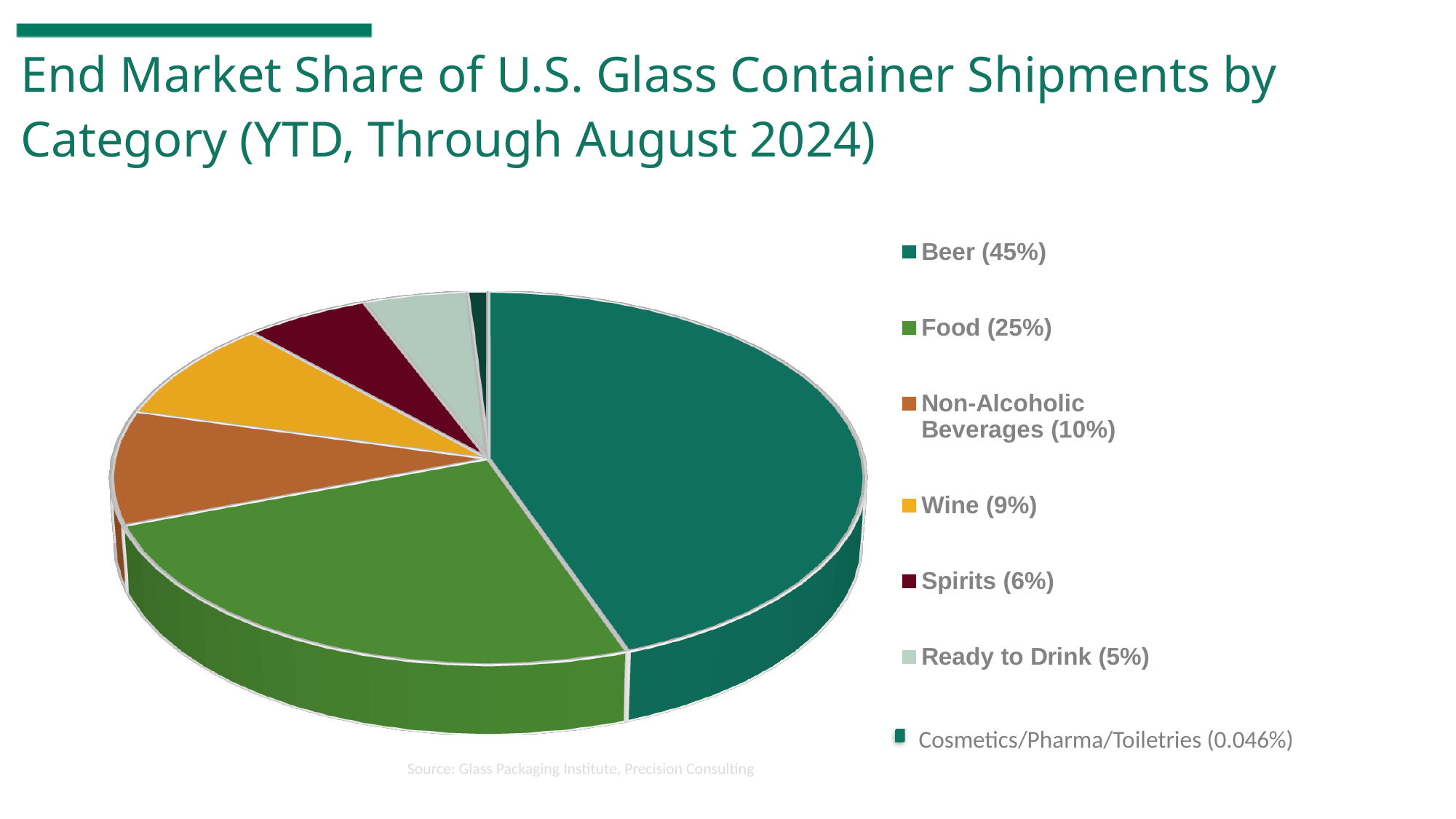
How many categories are shown in the pie chart? 7 What is the title of the chart? End Market Share of U.S. Glass Container Shipments by Category (YTD, Through August 2024) What share does Food account for in the pie chart? 25% What share of U.S. glass container shipments does Beer account for? 45% How many percentage points larger is Beer's share than Food's share? 20 Which has a larger share, Spirits or Ready to Drink? Spirits What is the share for Cosmetics/Pharma/Toiletries? 0.046% Which category has the smallest share of shipments? Cosmetics/Pharma/Toiletries What type of chart is shown on the slide? Pie chart Which category has the largest share of shipments? Beer What is the share for Non-Alcoholic Beverages? 10% What share does Wine hold? 9%